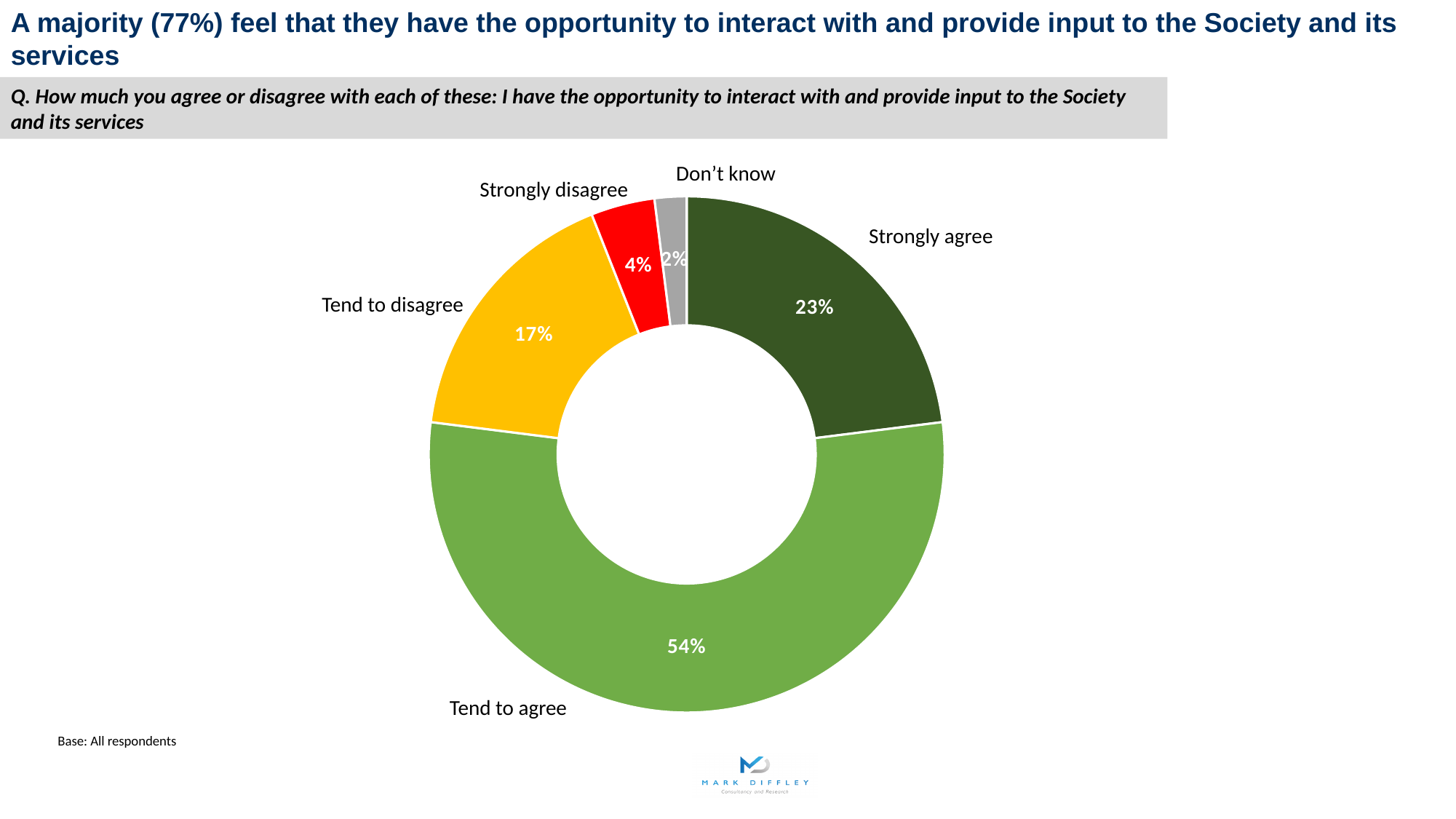
What is the difference in percentage points between 'Tend to agree' and 'Strongly agree'? 31 What percentage of respondents tend to disagree? 17% What percentage of respondents strongly disagree? 4% What percentage of respondents strongly agree that they have the opportunity to interact with and provide input to the Society and its services? 23% Which response category has the largest share of the chart? Tend to agree How many response categories are shown in the chart? 5 What percentage of respondents tend to agree? 54% Which response category has the smallest share of the chart? Don't know Which is larger: the share for 'Tend to disagree' or the share for 'Strongly disagree'? Tend to disagree What kind of chart is shown on the slide? Doughnut (pie) chart What percentage of respondents answered 'Don't know'? 2% What colour is the 'Tend to disagree' segment of the chart? Yellow